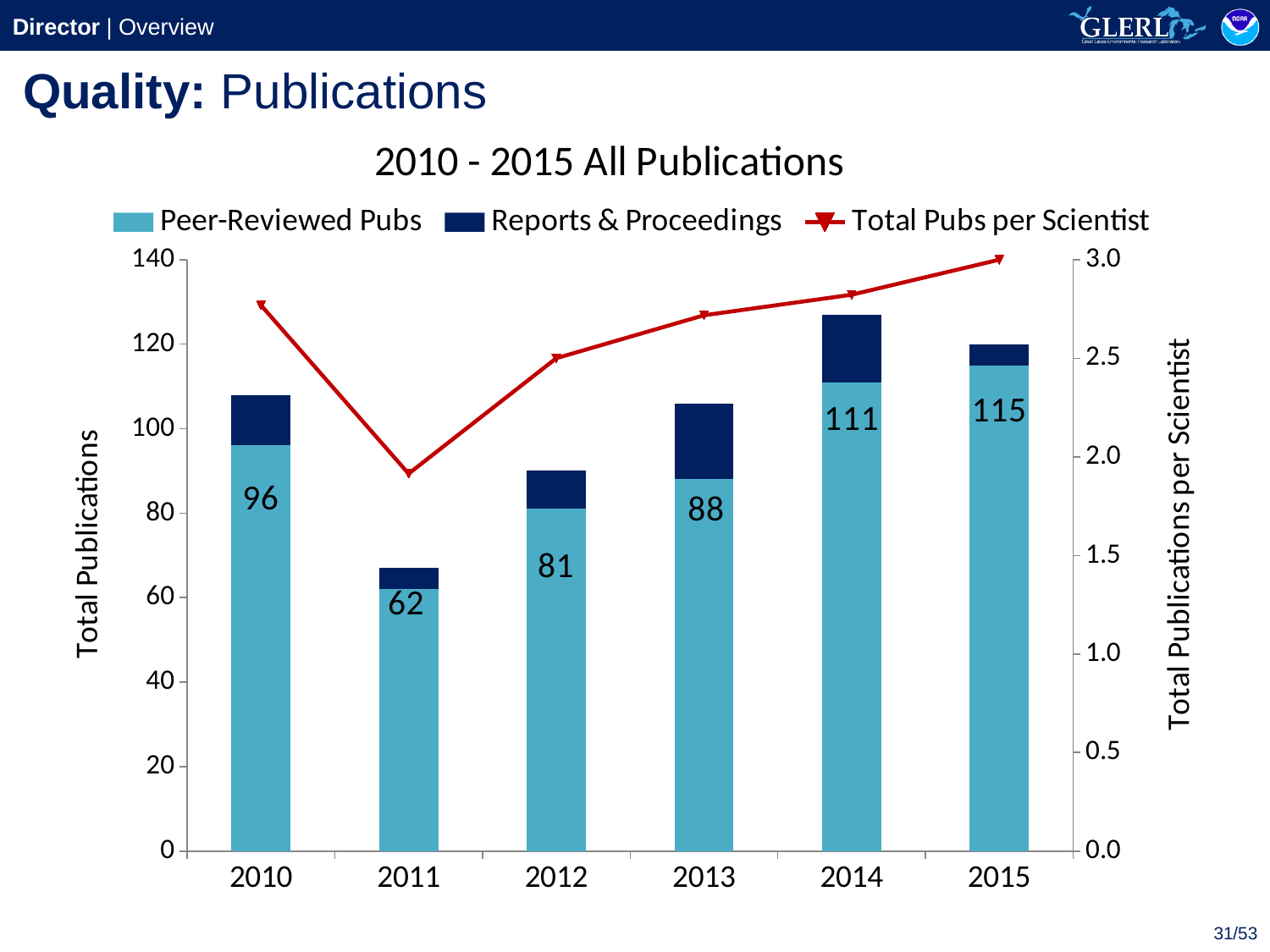
Is the value for Total Pubs per Scientist in 2011 greater or less than 2.0? less Is the total stacked bar for 2014 greater or less than 120? greater How many series does the legend list? 3 Which year has the highest number of Peer-Reviewed Pubs? 2015 What is the difference in Peer-Reviewed Pubs between 2015 and 2011? 53 Which year has the lowest number of Peer-Reviewed Pubs? 2011 What is the value for Peer-Reviewed Pubs in 2014? 111 Which year has more Peer-Reviewed Pubs, 2012 or 2013? 2013 What kind of chart is this? Stacked bar chart with a line How many years are shown on the x axis? 6 Does the Total Pubs per Scientist line rise or fall from 2011 to 2015? rise What is the value for Peer-Reviewed Pubs in 2010? 96